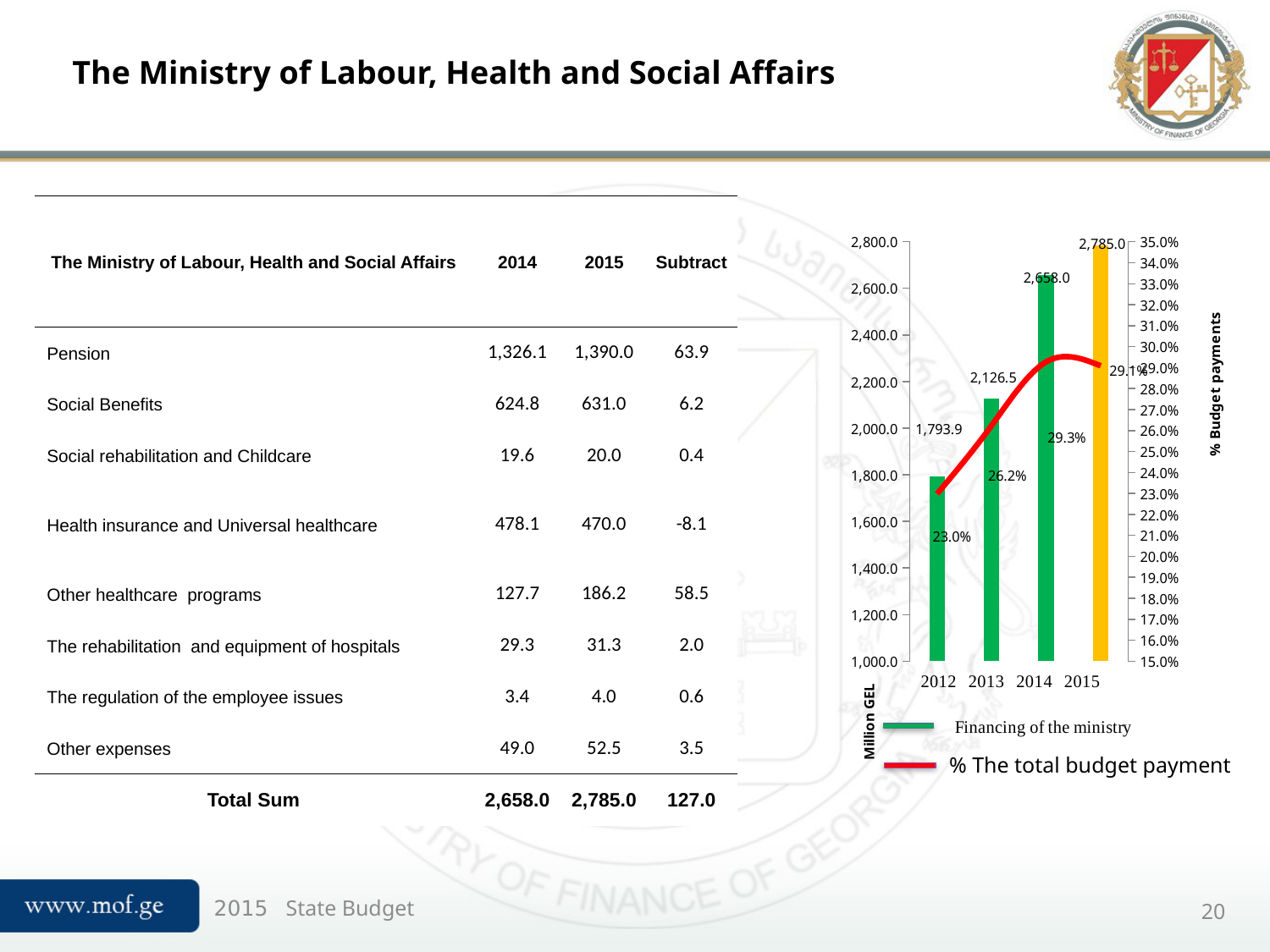
What is the value of Financing of the ministry for 2015? 2,785.0 What is the % The total budget payment value for 2012? 23.0% What is the label of the left vertical axis of the chart? Million GEL Does Financing of the ministry rise or fall from 2012 to 2015? rise How many years are shown on the x axis of the chart? 4 Which year has the highest Financing of the ministry? 2015 What is the value of Financing of the ministry for 2013? 2,126.5 How many series does the chart legend list? 2 Which year has the lowest % The total budget payment? 2012 What is the difference in Financing of the ministry between 2015 and 2014? 127.0 What is the % The total budget payment value for 2014? 29.3% Which is larger, the % The total budget payment for 2014 or for 2015? 2014